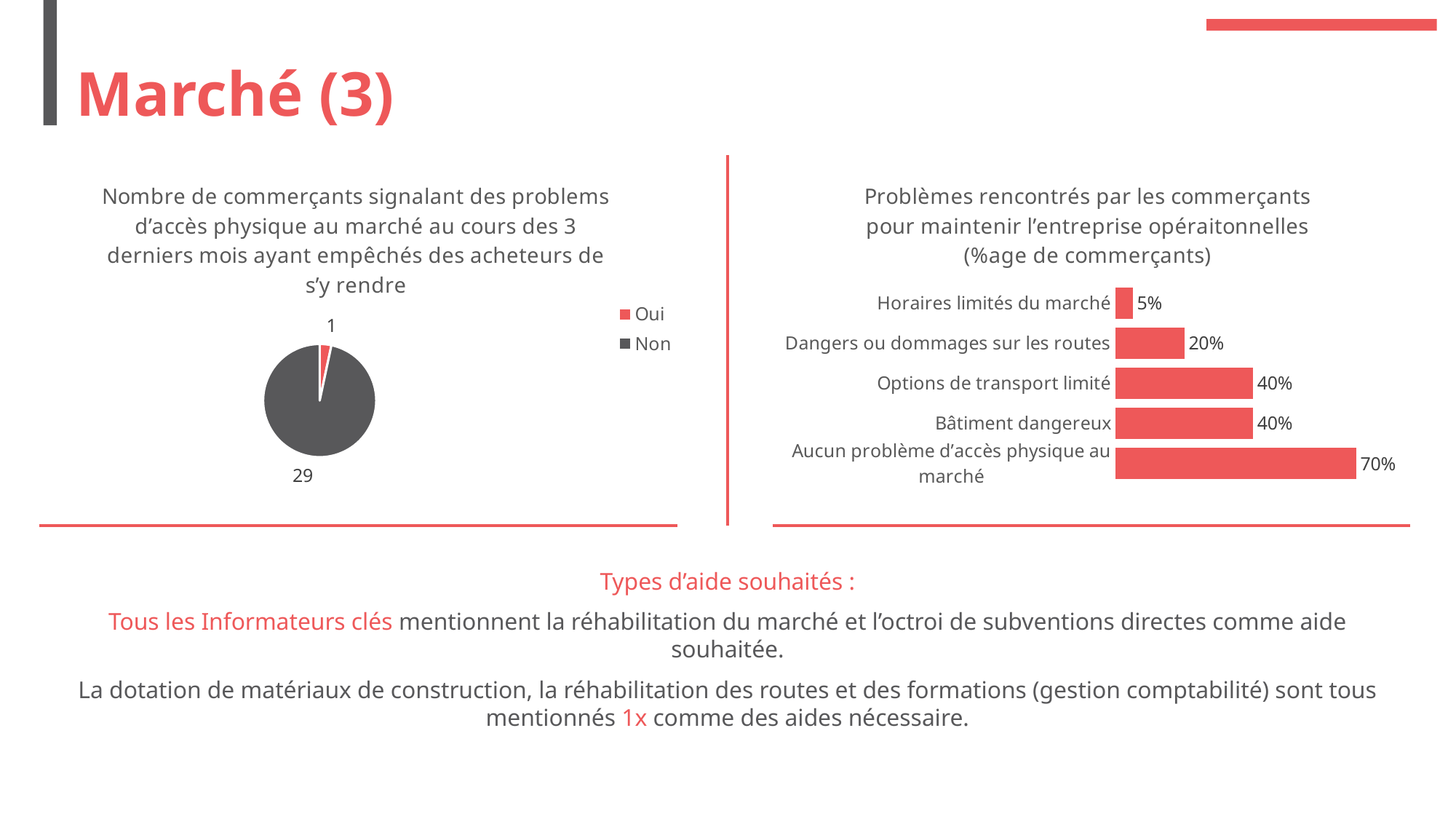
In the pie chart on the left, what is the value for "Oui"? 1 In the pie chart on the left, what is the value for "Non"? 29 In the bar chart on the right, what is the difference between "Options de transport limité" and "Dangers ou dommages sur les routes"? 20% In the pie chart on the left, which category is larger, "Oui" or "Non"? Non In the bar chart on the right, what is the value for "Dangers ou dommages sur les routes"? 20% In the pie chart on the left, how many entries does the legend list? 2 In the bar chart on the right, which category has the lowest value? Horaires limités du marché What kind of chart is the chart on the left? Pie chart How many categories are shown in the bar chart on the right? 5 In the bar chart on the right, which category has the highest value? Aucun problème d'accès physique au marché In the bar chart on the right, what is the value for "Aucun problème d'accès physique au marché"? 70% In the bar chart on the right, what is the value for "Horaires limités du marché"? 5%